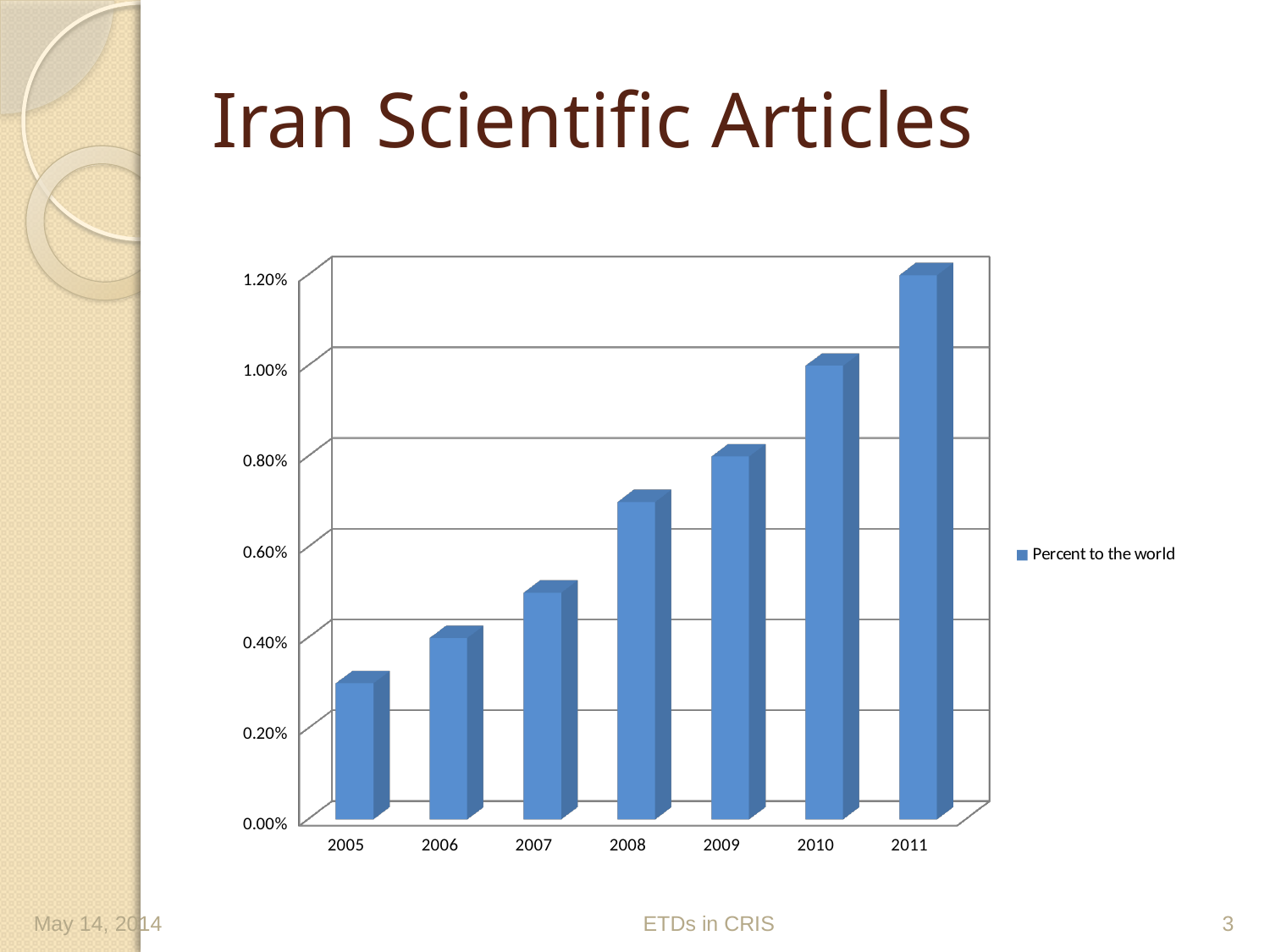
Is the value for 2005 greater or less than 0.40%? less Which year has the larger value, 2006 or 2009? 2009 Which year has the highest value in the chart? 2011 Is the value for 2007 greater or less than 0.60%? less Is the value for 2008 greater or less than 0.60%? greater Do the values rise or fall from 2005 to 2011? Rise What is the title of the slide containing the chart? Iran Scientific Articles How many series does the chart legend list? 1 What kind of chart is shown on the slide? Bar chart Which year has the lowest value in the chart? 2005 How many years are shown on the x axis of the chart? 7 What is the name of the series shown in the chart legend? Percent to the world